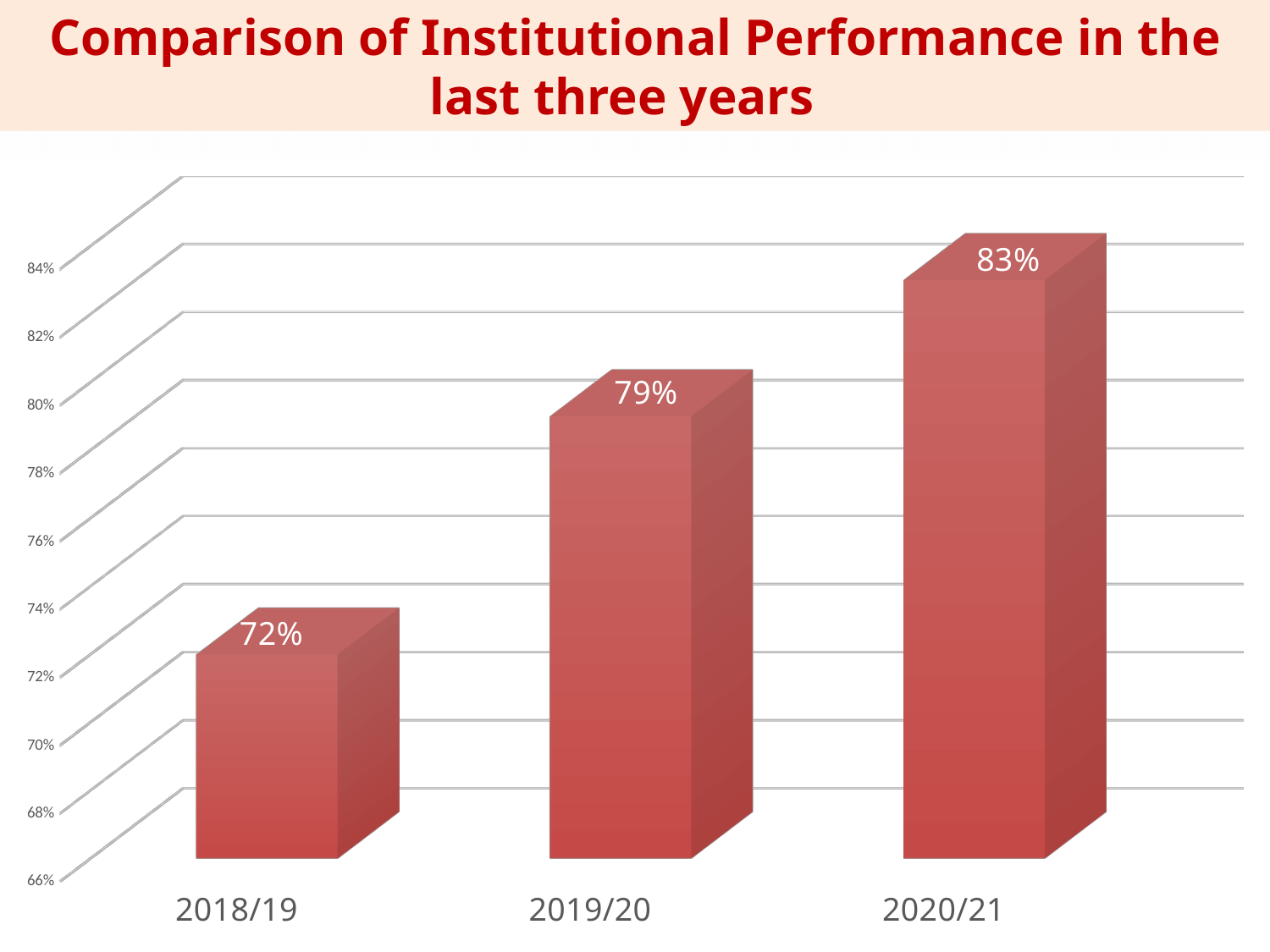
Which year has the highest institutional performance? 2020/21 What kind of chart is shown on the slide? Bar chart Do the performance values rise or fall from 2018/19 to 2020/21? Rise Which year has a higher performance value, 2019/20 or 2020/21? 2020/21 What is the institutional performance value for 2019/20? 79% How many years are shown in the chart? 3 Which year has the lowest institutional performance? 2018/19 Is the value for 2019/20 greater or less than 76%? greater What is the institutional performance value for 2018/19? 72% What is the institutional performance value for 2020/21? 83% What is the difference in performance between 2019/20 and 2018/19? 7% What is the difference in performance between 2020/21 and 2018/19? 11%